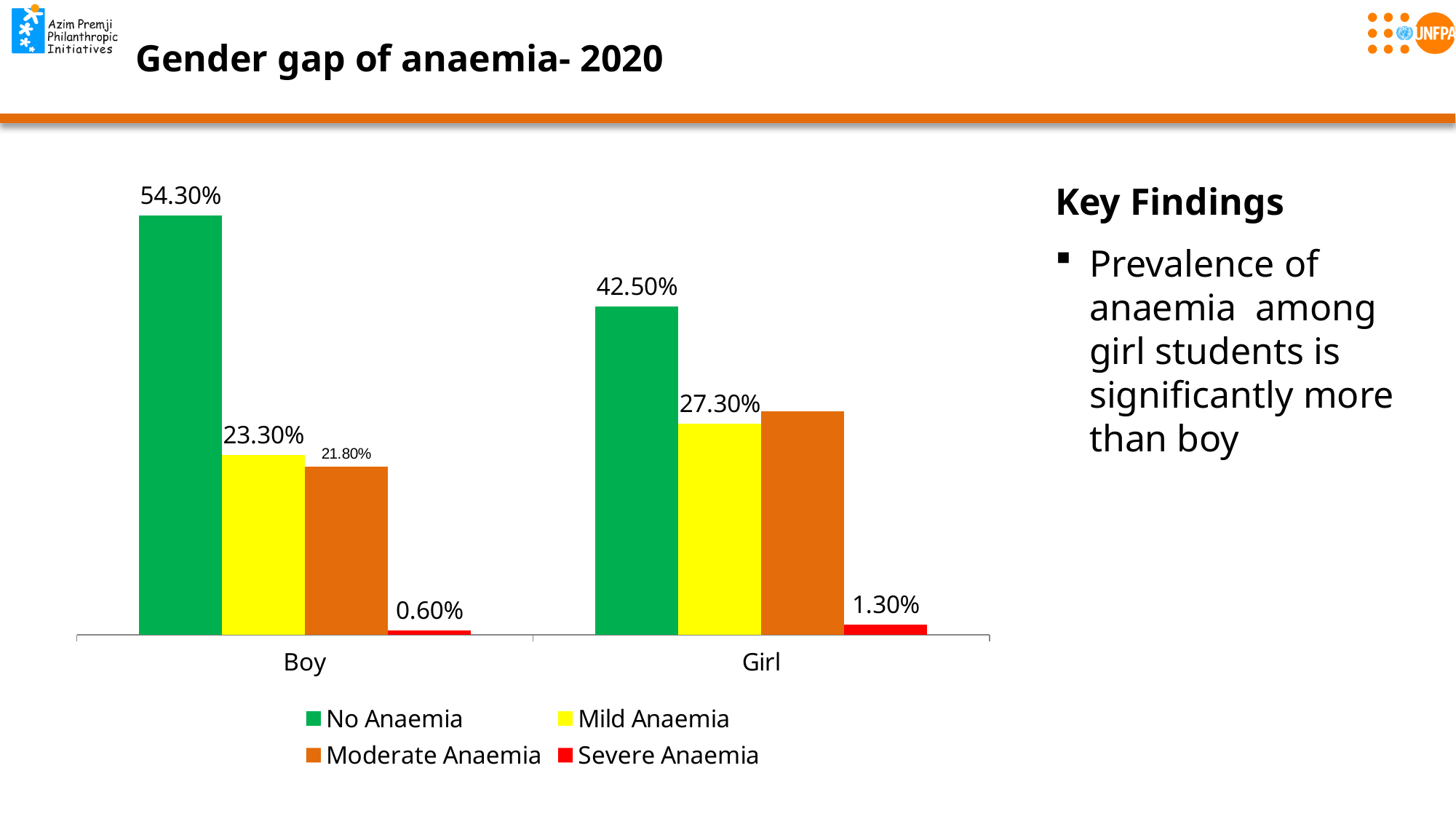
Which is larger: Moderate Anaemia for girls or Mild Anaemia for girls? Moderate Anaemia What kind of chart is shown on the slide? Bar chart Which series has the highest value in the Girl group? No Anaemia Which is larger: Severe Anaemia for boys or Severe Anaemia for girls? Girls (1.30%) Which series has the lowest value in the Boy group? Severe Anaemia What is the difference between the No Anaemia values for boys and girls? 11.80% What is the value for No Anaemia among boys? 54.30% How many series does the legend list? 4 What is the value for Severe Anaemia among boys? 0.60% What is the value for Mild Anaemia among girls? 27.30% How many categories are shown on the x axis? 2 What is the value for Moderate Anaemia among boys? 21.80%